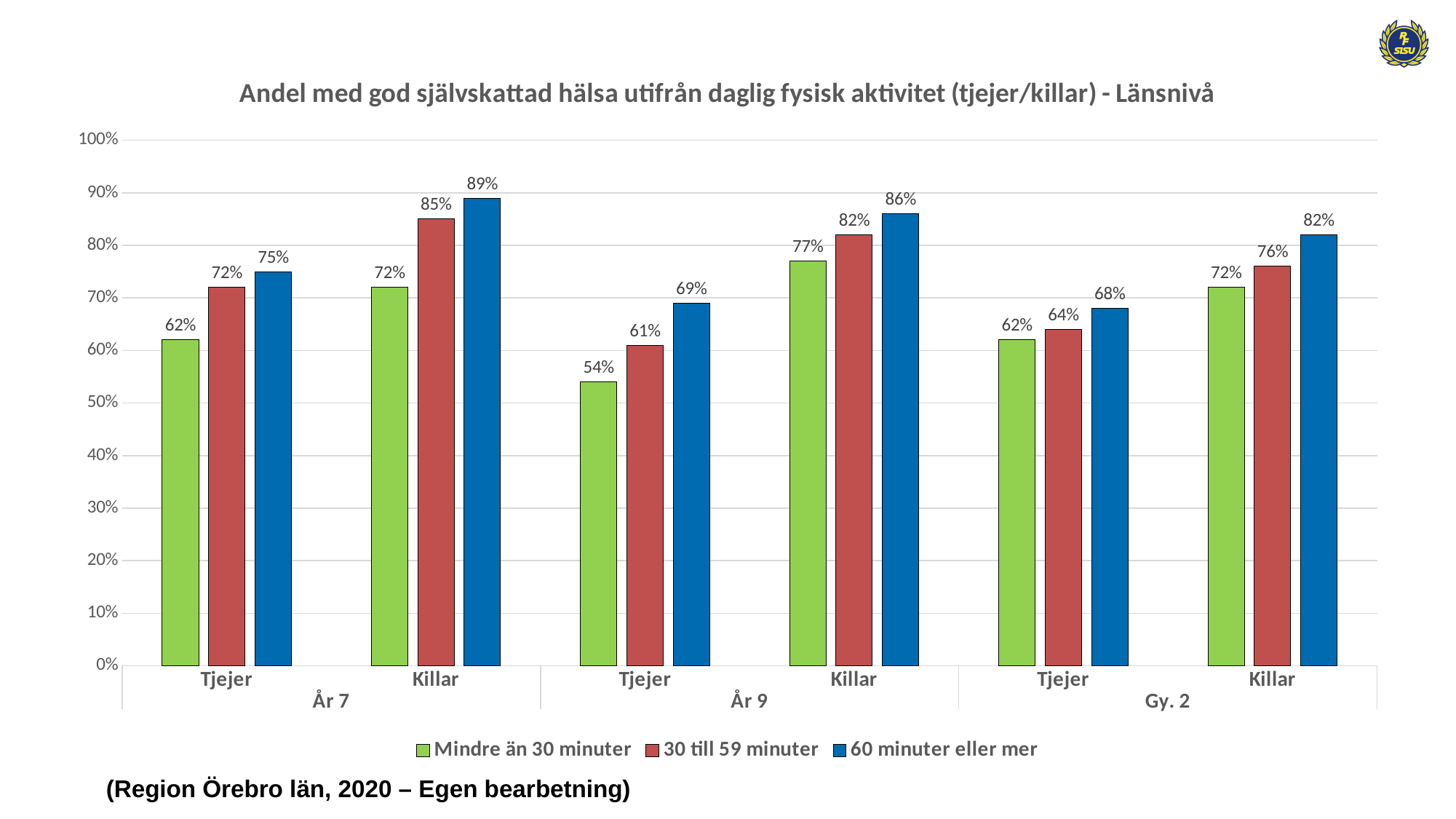
Which group and series has the highest value in the chart? Killar, År 7, 60 minuter eller mer (89%) Within each Tjejer or Killar group, do the values rise or fall from 'Mindre än 30 minuter' to '60 minuter eller mer'? Rise Which group and series has the lowest value in the chart? Tjejer, År 9, Mindre än 30 minuter (54%) How many Tjejer/Killar groups are shown along the x axis? 6 What is the value for Killar in År 7 for the series '60 minuter eller mer'? 89% What is the value for Tjejer in Gy. 2 for the series '30 till 59 minuter'? 64% What kind of chart is shown on the slide? Bar chart How many series does the legend list? 3 What colour represents the series '60 minuter eller mer'? Blue What is the difference between Killar and Tjejer in År 9 for the series '60 minuter eller mer'? 17 percentage points Which is larger: Tjejer in År 7 for '60 minuter eller mer' or Killar in Gy. 2 for '30 till 59 minuter'? Killar in Gy. 2 for '30 till 59 minuter' (76%) What is the value for Tjejer in År 9 for the series 'Mindre än 30 minuter'? 54%